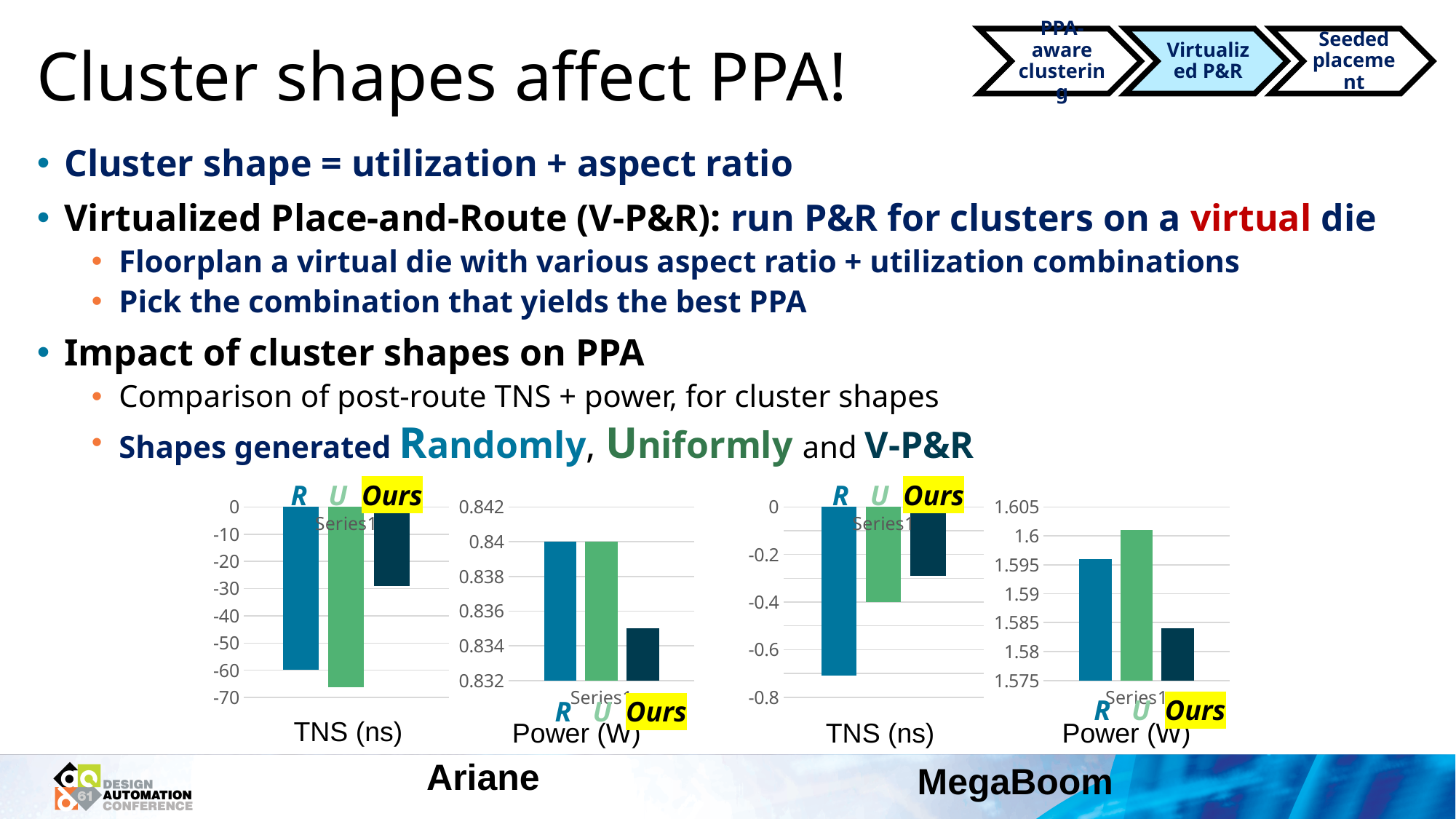
How many bars are plotted in the Ariane Power (W) chart? 3 In the Ariane Power (W) chart, is the value for Ours greater or less than 0.836? less In the MegaBoom Power (W) chart, is the value for Ours greater or less than 1.59? less In the MegaBoom Power (W) chart, which bar has the highest value? U In the Ariane TNS (ns) chart, is the value for U greater or less than -60? less In the MegaBoom TNS (ns) chart, which bar reaches the lowest (most negative) value? R What kind of chart is the Ariane TNS (ns) chart? bar chart In the Ariane TNS (ns) chart, which bar reaches the lowest (most negative) value? U In the Ariane Power (W) chart, which bar has the lowest value? Ours Which two benchmark names label the groups of charts at the bottom of the slide? Ariane and MegaBoom